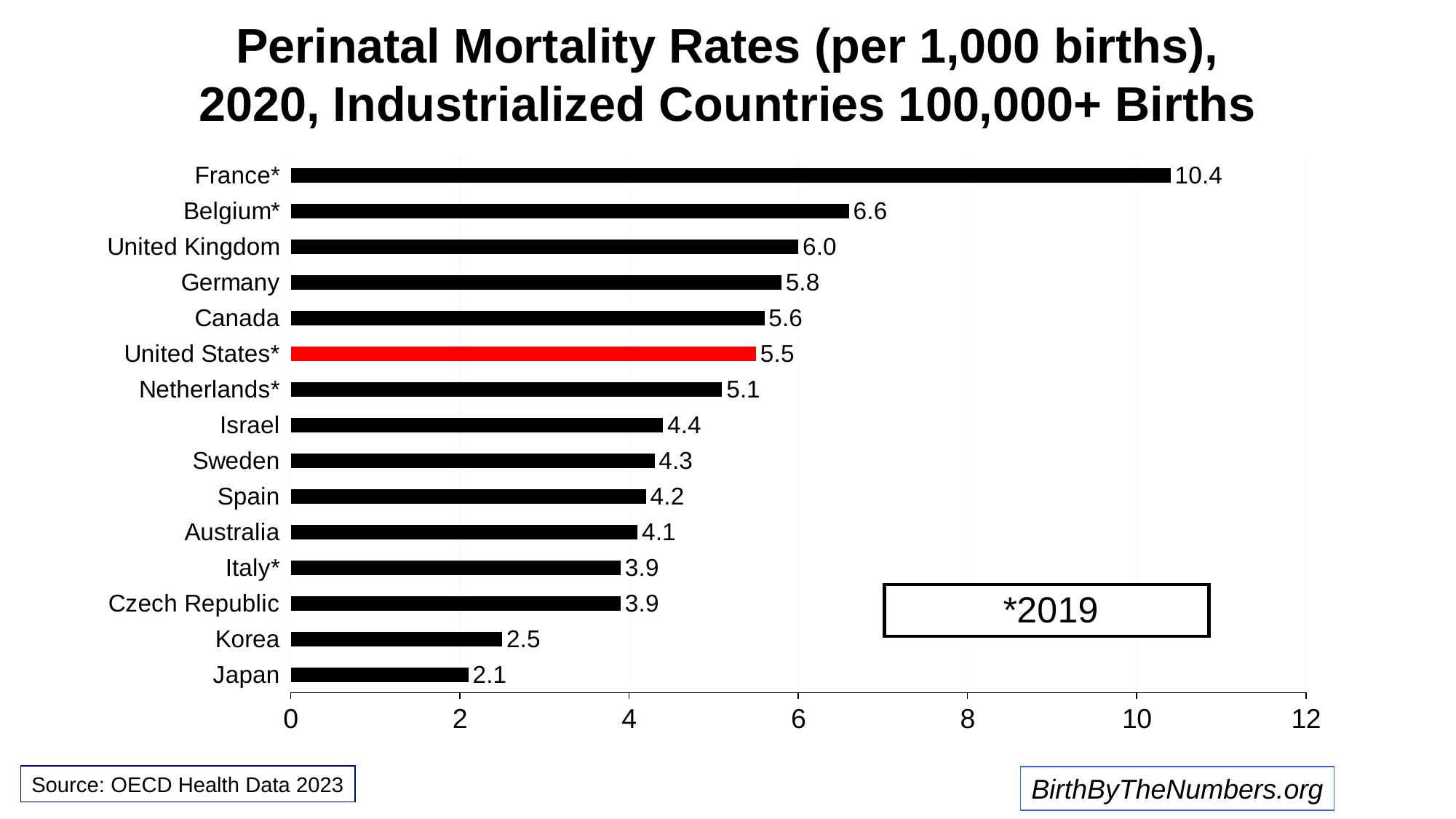
What is the perinatal mortality rate shown for the United States*? 5.5 How many countries are shown on the chart? 15 What is the difference between the rates for the United States* and Japan? 3.4 What kind of chart is shown on the slide? Bar chart Which country has the highest perinatal mortality rate on the chart? France* Which country has the lowest perinatal mortality rate on the chart? Japan What is the perinatal mortality rate shown for Japan? 2.1 Which country's bar is coloured red? United States* Is the value for the United Kingdom greater or less than 4? greater What is the perinatal mortality rate shown for Germany? 5.8 What is the difference between the rates for France* and Belgium*? 3.8 Which has a higher perinatal mortality rate, Canada or Netherlands*? Canada